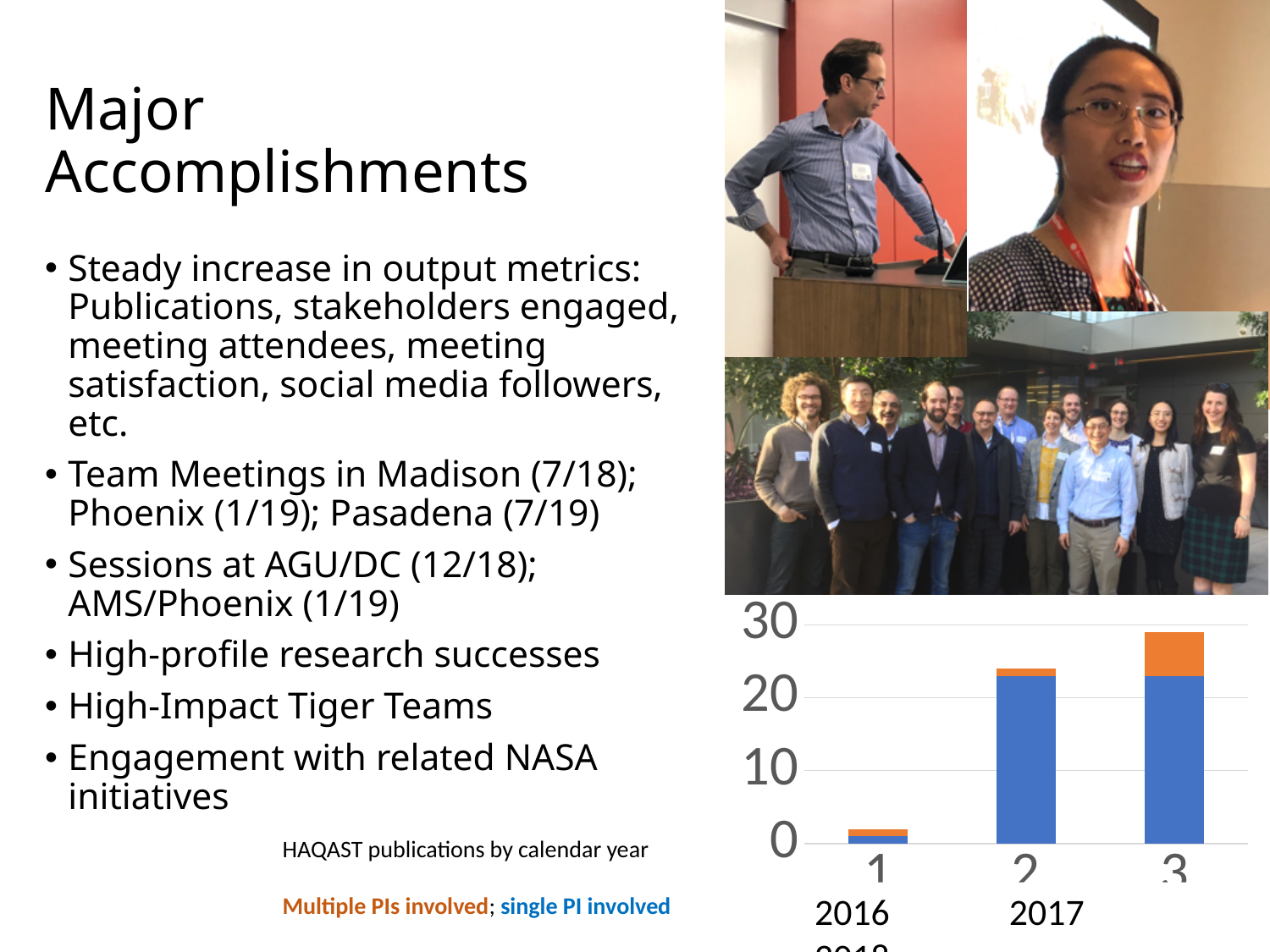
What is the title of the chart on the slide? HAQAST publications by calendar year Which has a larger total of publications, 2016 or 2017? 2017 How many series does the legend of the publications chart list? 2 Is the total for the rightmost bar greater or less than 30? less What kind of chart is shown at the bottom right of the slide? stacked bar chart Is the total for 2016 greater or less than 10? less Is the total for 2017 greater or less than 20? greater Which colour represents 'single PI involved' in the chart? blue Do the total publications rise or fall from left to right across the years? rise Which bar has the highest total in the publications chart? the rightmost (third) bar How many bars (calendar years) are plotted in the publications chart? 3 Which year has the lowest total number of publications in the chart? 2016